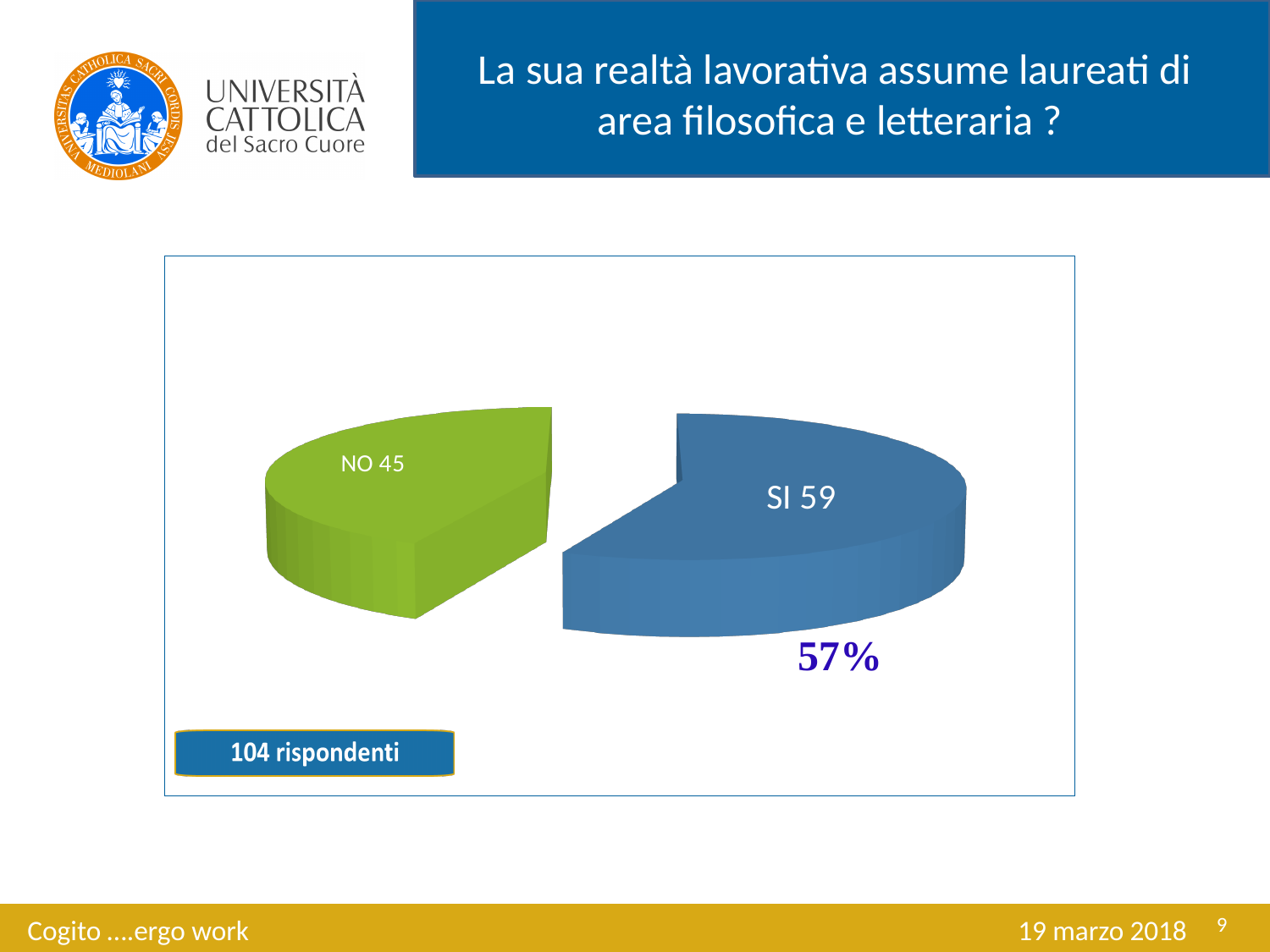
Which is larger, SI or NO? SI What is the value for SI? 59 What colour is the NO slice? green How many respondents does the label in the chart box report? 104 What kind of chart is shown on the slide? pie chart Which slice has the highest value? SI What is the difference between the SI and NO values? 14 How many slices does the pie chart have? 2 What percentage is printed next to the SI slice? 57% What is the total of the two slices? 104 Which slice has the lowest value? NO What is the value for NO? 45